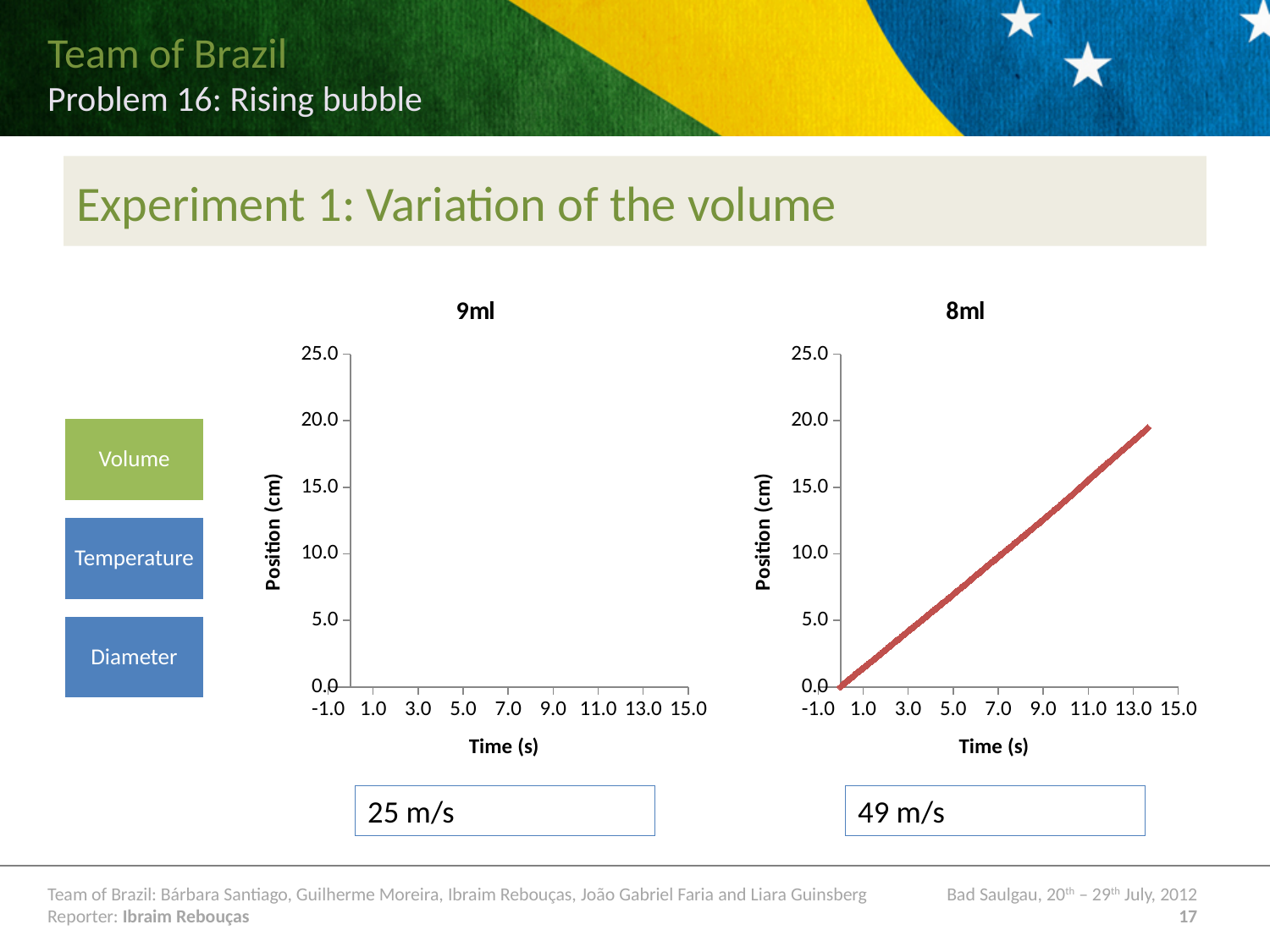
In the 8ml chart, is the position at time 13.0 s greater or less than 15.0 cm? greater In the 8ml chart, does the position rise or fall as time increases? rise In the 8ml chart, is the position at time 9.0 s greater or less than 10.0 cm? greater In the 8ml chart, is the position at time 5.0 s greater or less than 10.0 cm? less How many charts are shown on the slide? 2 What kind of chart is the 8ml chart? line chart What is the title of the x axis on the 9ml chart? Time (s) What is the title of the y axis on the 8ml chart? Position (cm)